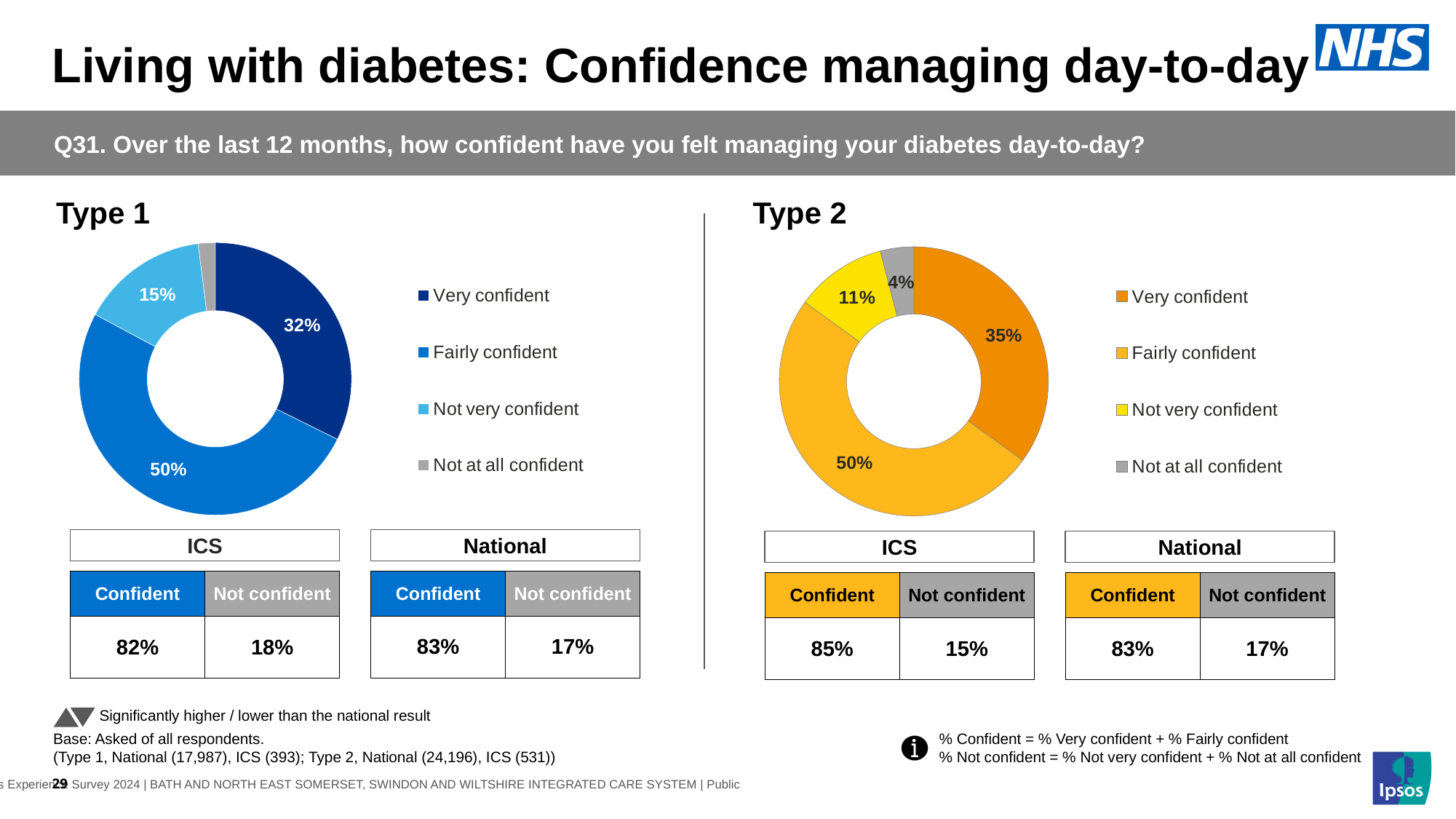
In the Type 2 chart, what percentage of respondents were not very confident? 11% In the Type 1 chart, what percentage of respondents were fairly confident? 50% In the Type 2 chart, which category has the largest share? Fairly confident How many categories does the legend of the Type 1 chart list? 4 In the Type 2 chart, what percentage of respondents were very confident? 35% Which is larger: the Very confident share in the Type 1 chart or in the Type 2 chart? Type 2 In the Type 1 chart, what percentage of respondents were not very confident? 15% What kind of chart is used for Type 2? Donut (pie) chart In the Type 1 chart, what percentage of respondents were very confident? 32% In the Type 2 chart, what is the difference between the Very confident and Not very confident shares? 24 percentage points In the Type 2 chart, what percentage of respondents were not at all confident? 4% In the Type 1 chart, which category has the smallest share? Not at all confident